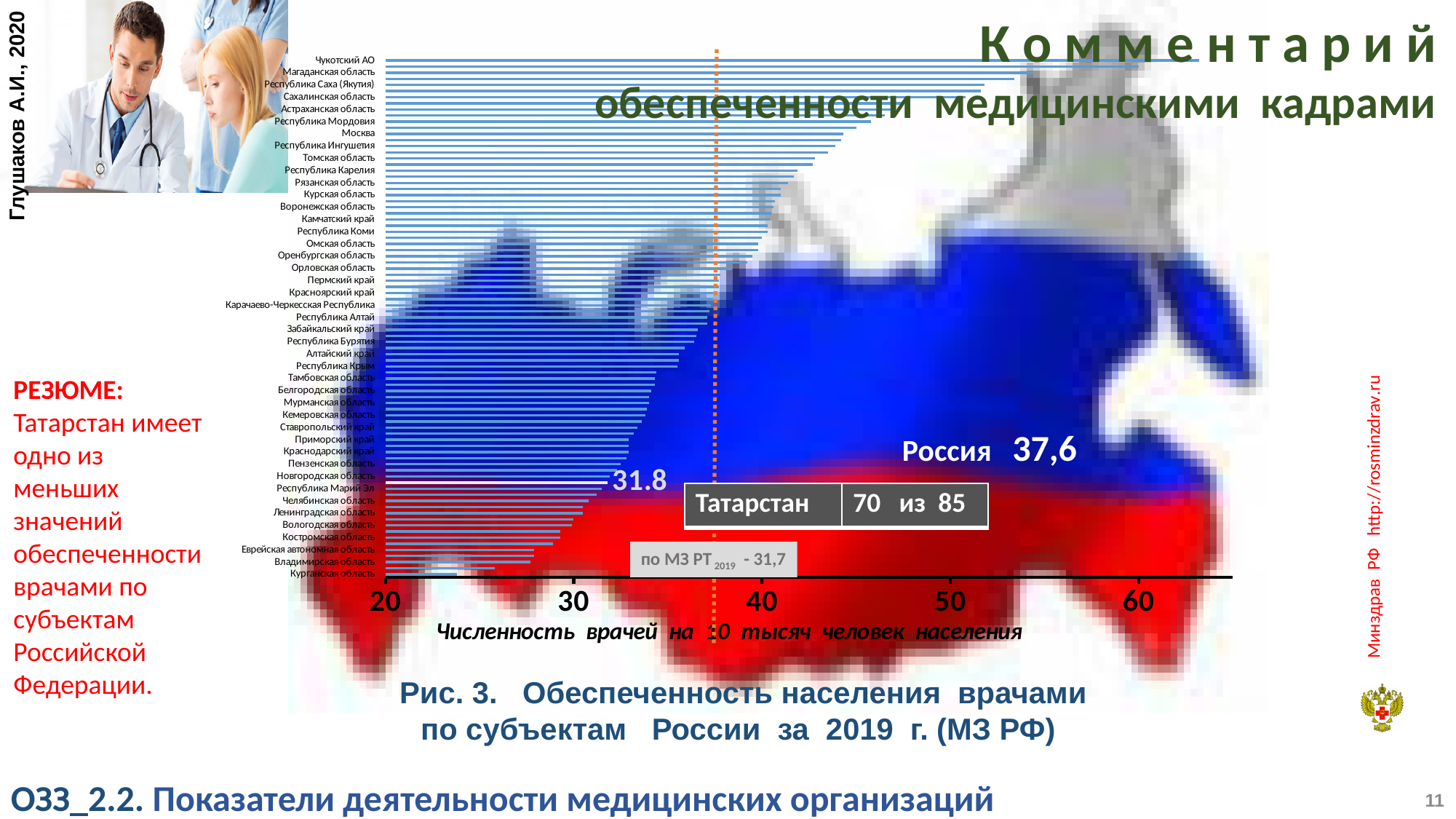
What is the value shown for Россия on the chart? 37,6 What is the x-axis title of the chart? Численность врачей на 10 тысяч человек населения Is the value for Москва greater or less than 40? greater Is the value for Чукотский АО greater or less than 50? greater Which region has the lowest number of doctors per 10 thousand population on the chart? Курганская область Is the value for Курганская область greater or less than 30? less What kind of chart is shown in Рис. 3? bar chart What is the difference between the value for Россия (37,6) and the value for Татарстан (31.8)? 5.8 Which has a larger value, Москва or Курская область? Москва Which region has the highest number of doctors per 10 thousand population on the chart? Чукотский АО What is the value shown for Татарстан on the chart? 31.8 Do the bar values increase or decrease going from the top region to the bottom region of the chart? decrease